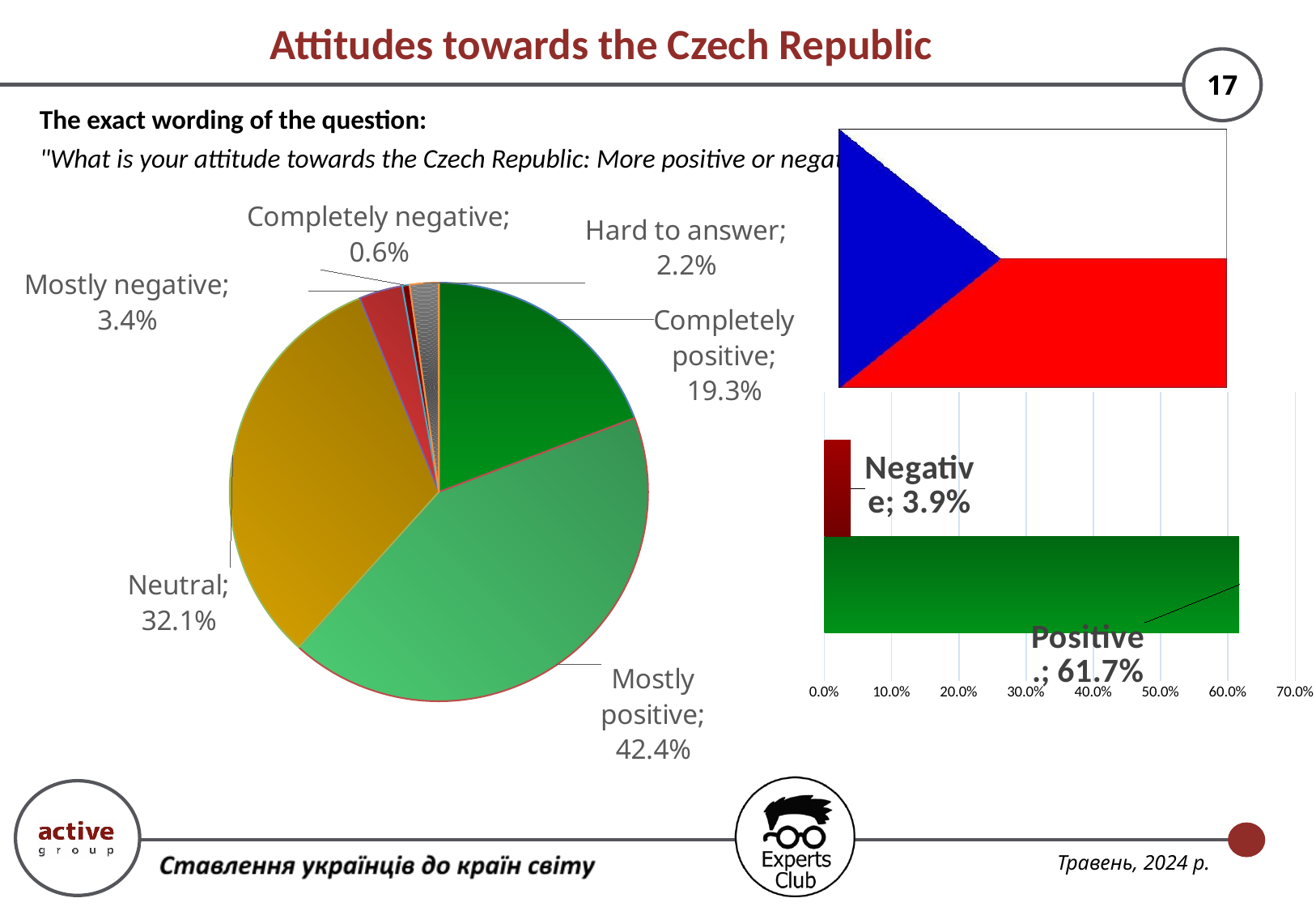
What kind of chart is shown at the bottom right of the slide? Bar chart In the pie chart on the left, what is the difference between the "Mostly positive" and "Completely positive" shares? 23.1% In the pie chart on the left, what share of respondents answered "Neutral"? 32.1% In the pie chart on the left, how many categories are shown? 6 In the pie chart on the left, which category has the largest share? Mostly positive In the pie chart on the left, which is larger: "Mostly negative" or "Hard to answer"? Mostly negative In the pie chart on the left, which category has the smallest share? Completely negative In the pie chart on the left, what share of respondents answered "Mostly positive"? 42.4% In the bar chart on the right, what is the value for "Positive"? 61.7% In the bar chart on the right, what is the difference between the "Positive" and "Negative" values? 57.8% In the bar chart on the right, what is the value for "Negative"? 3.9% In the pie chart on the left, what share of respondents answered "Completely negative"? 0.6%